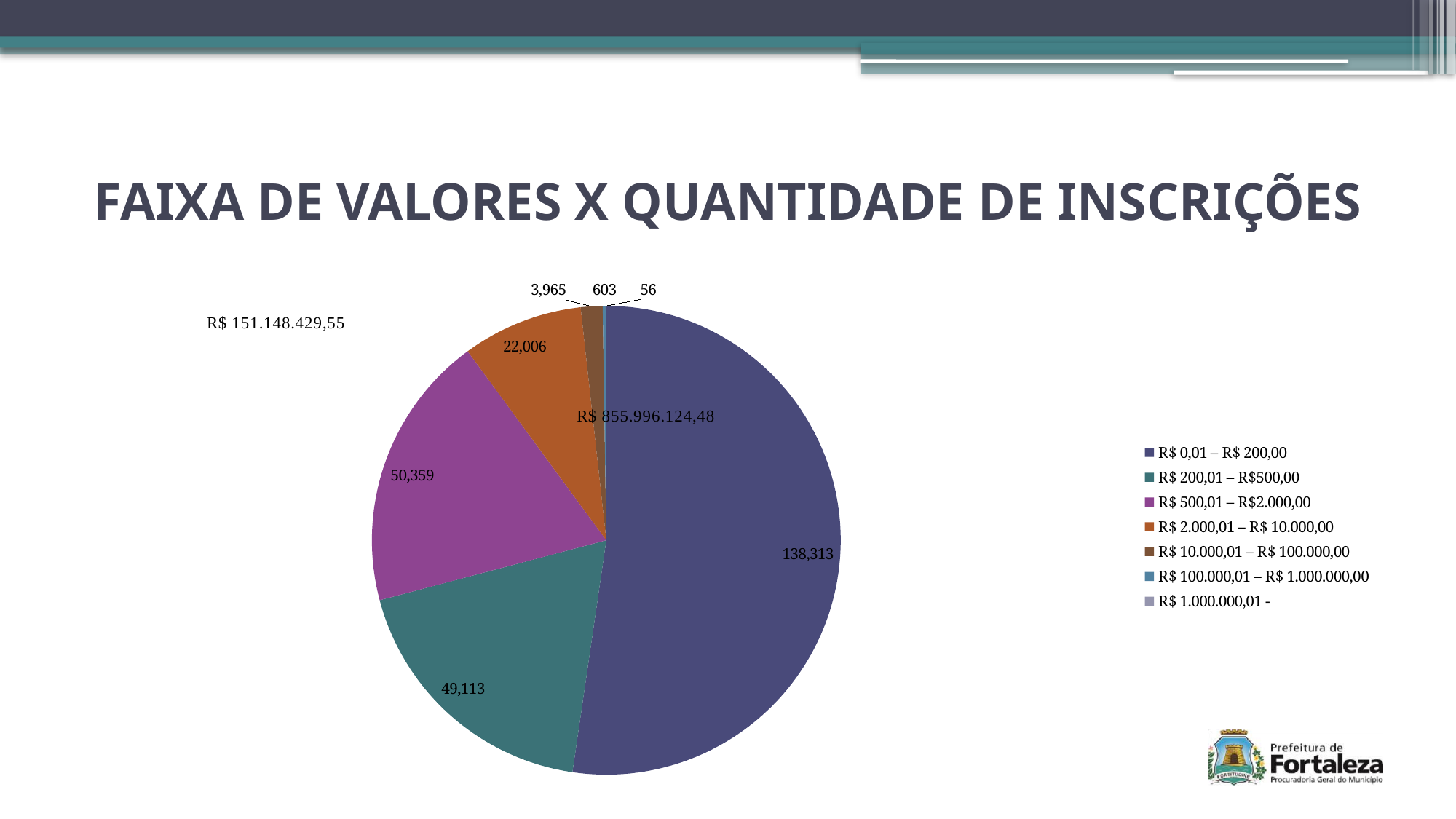
Which category has the largest slice of the pie? R$ 0,01 – R$ 200,00 What is the value for the R$ 500,01 – R$2.000,00 slice? 50,359 How many categories does the legend of the pie chart list? 7 What is the title of the chart on the slide? FAIXA DE VALORES X QUANTIDADE DE INSCRIÇÕES What type of chart is shown on the slide? Pie chart What is the value for the R$ 1.000.000,01 - slice? 56 What is the difference between the R$ 500,01 – R$2.000,00 slice and the R$ 200,01 – R$500,00 slice? 1,246 Which is larger, the value for R$ 2.000,01 – R$ 10.000,00 or the value for R$ 10.000,01 – R$ 100.000,00? R$ 2.000,01 – R$ 10.000,00 What is the value for the R$ 2.000,01 – R$ 10.000,00 slice? 22,006 What is the value for the R$ 0,01 – R$ 200,00 slice? 138,313 Which category has the smallest slice of the pie? R$ 1.000.000,01 - What is the value for the R$ 200,01 – R$500,00 slice? 49,113